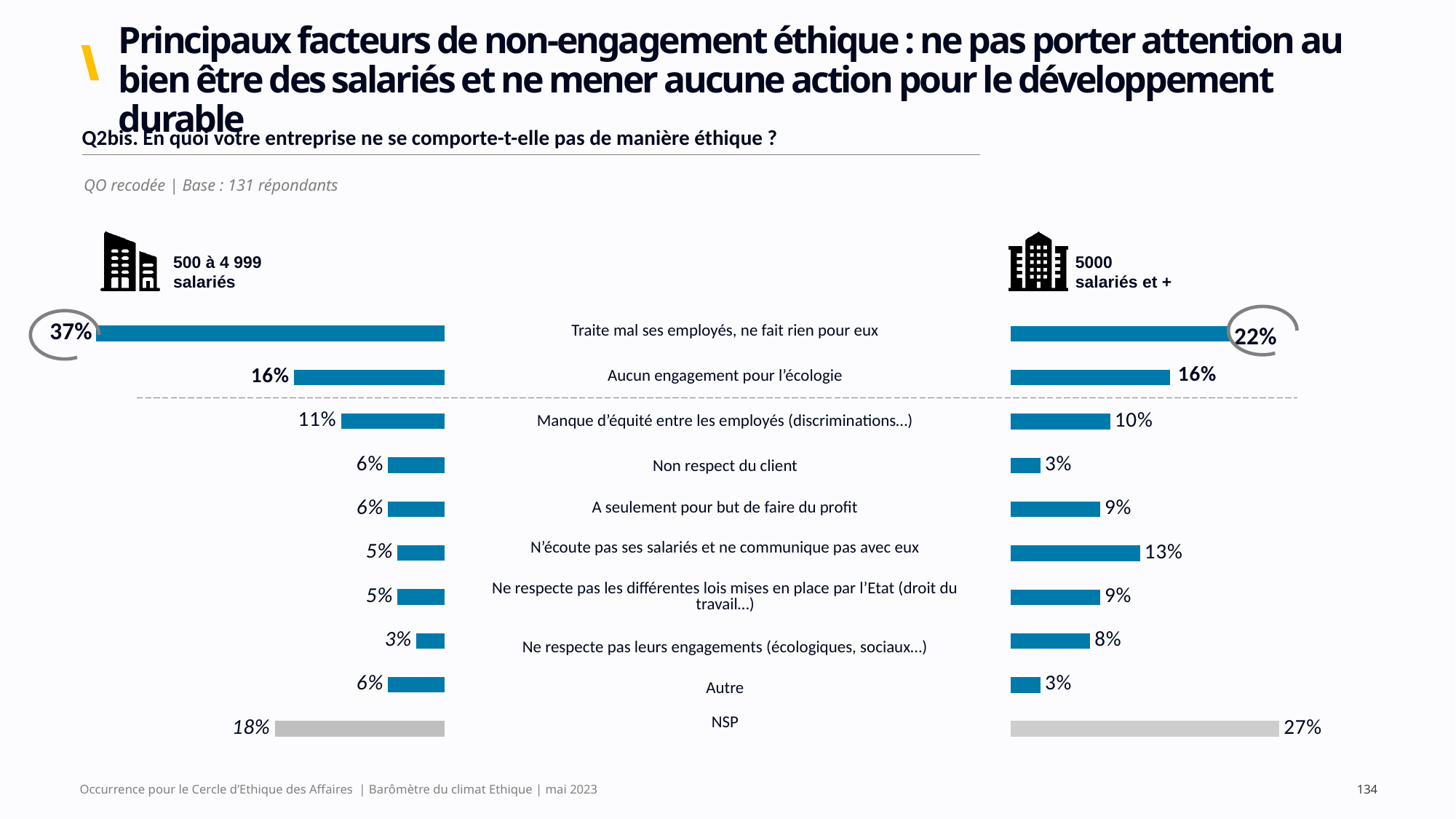
In the '500 à 4 999 salariés' chart, what is the difference between 'Aucun engagement pour l’écologie' and 'Manque d’équité entre les employés (discriminations…)'? 5 percentage points In the '500 à 4 999 salariés' chart, which category has the lowest value? Ne respecte pas leurs engagements (écologiques, sociaux…) In the '500 à 4 999 salariés' chart, which category has the highest value? Traite mal ses employés, ne fait rien pour eux What type of chart is used on this slide? Bar chart How many categories are shown in each chart? 10 In the '5000 salariés et +' chart, what is the value for 'Non respect du client'? 3% What is the difference between the values for 'Traite mal ses employés, ne fait rien pour eux' in the '500 à 4 999 salariés' chart and the '5000 salariés et +' chart? 15 percentage points In the '5000 salariés et +' chart, what is the value for 'NSP'? 27% In the '5000 salariés et +' chart, which category has the highest value among the blue bars? Traite mal ses employés, ne fait rien pour eux Which is larger: the value for 'A seulement pour but de faire du profit' in the '500 à 4 999 salariés' chart or in the '5000 salariés et +' chart? 5000 salariés et + In the '500 à 4 999 salariés' chart, what is the value for 'Traite mal ses employés, ne fait rien pour eux'? 37% In the '5000 salariés et +' chart, what is the value for 'N’écoute pas ses salariés et ne communique pas avec eux'? 13%